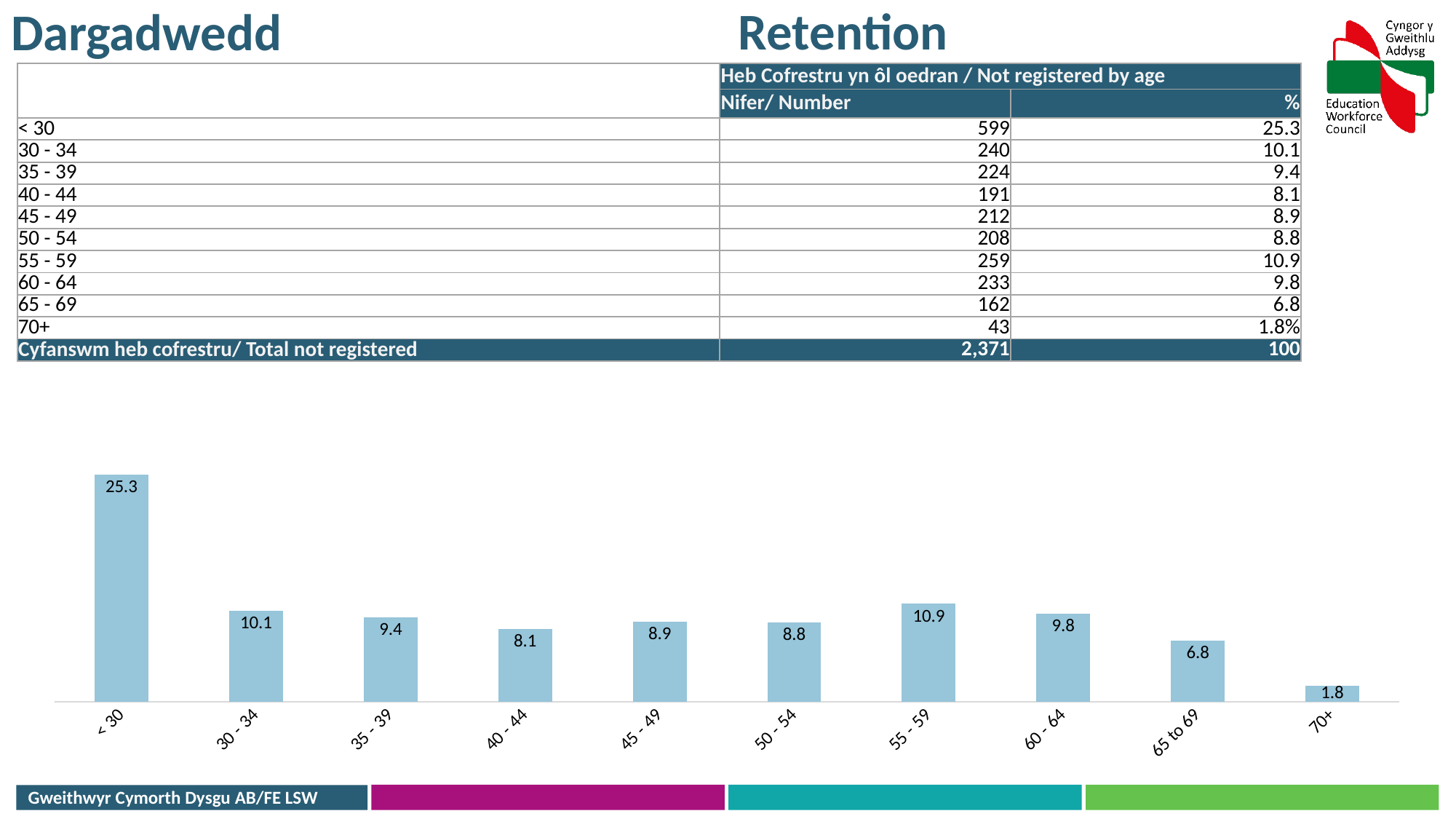
Which is larger, the value for 40 - 44 or the value for 65 to 69? 40 - 44 What is the difference between the values for < 30 and 30 - 34? 15.2 Which is larger, the value for 30 - 34 or the value for 60 - 64? 30 - 34 Which age category has the lowest bar? 70+ What is the value shown for the < 30 bar? 25.3 What is the value shown for the 70+ bar? 1.8 What is the difference between the values for 55 - 59 and 70+? 9.1 What is the value shown for the 55 - 59 bar? 10.9 What kind of chart is shown on the slide? bar chart How many age categories are plotted in the bar chart? 10 What is the value shown for the 65 to 69 bar? 6.8 Which age category has the highest bar? < 30